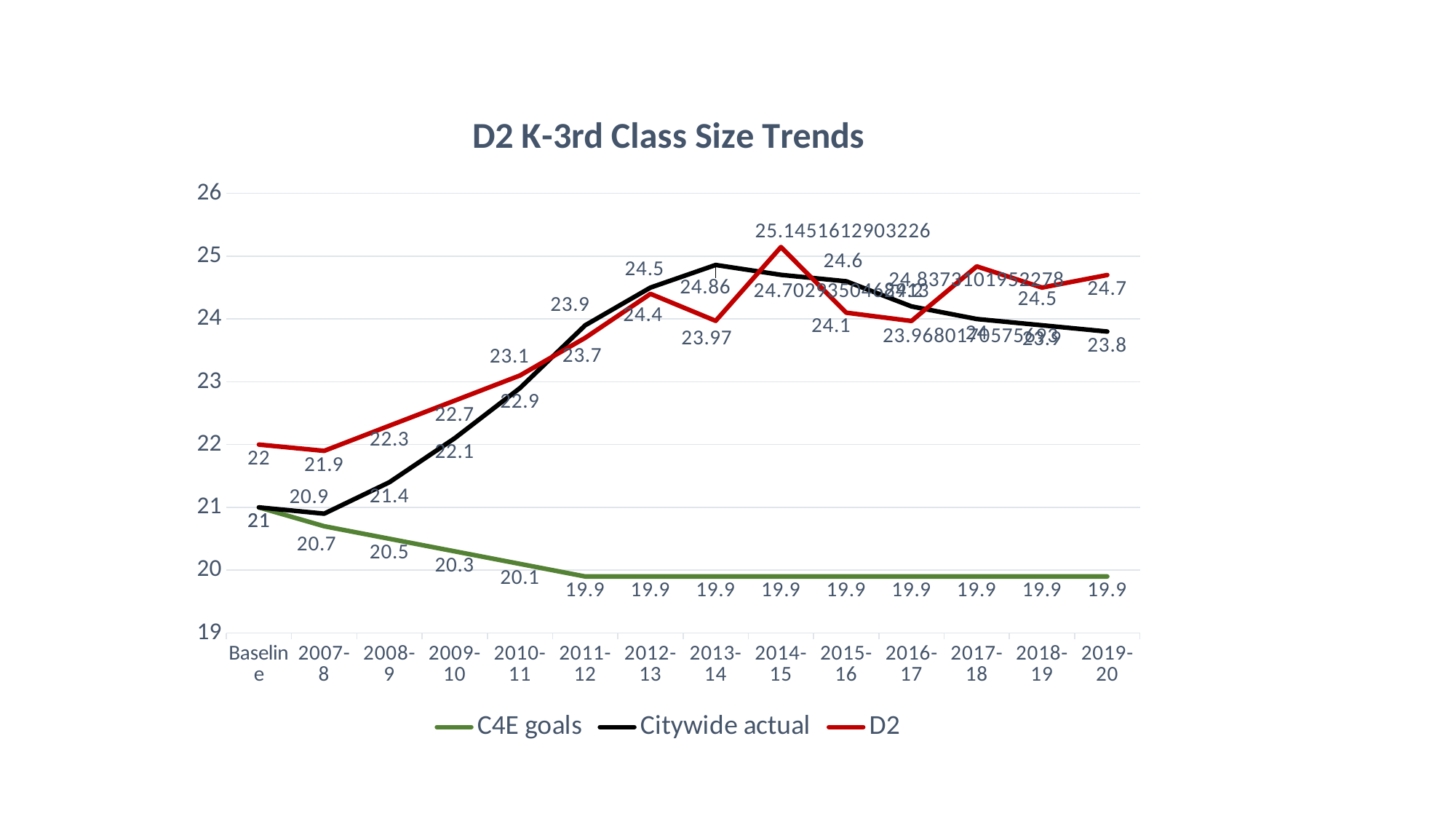
What is the difference between the D2 value and the Citywide actual value for 2019-20? 0.9 What type of chart is shown on the slide? line chart How many categories are shown on the x axis? 14 Does the C4E goals series rise or fall from Baseline to 2011-12? fall What is the Citywide actual value for 2013-14? 24.86 How many series does the legend list? 3 What is the D2 value for 2019-20? 24.7 In which category does the D2 series reach its highest value? 2014-15 What is the title of the chart? D2 K-3rd Class Size Trends What is the D2 value at Baseline? 22 Which is larger for 2012-13, the Citywide actual value or the D2 value? Citywide actual What is the C4E goals value for 2009-10? 20.3